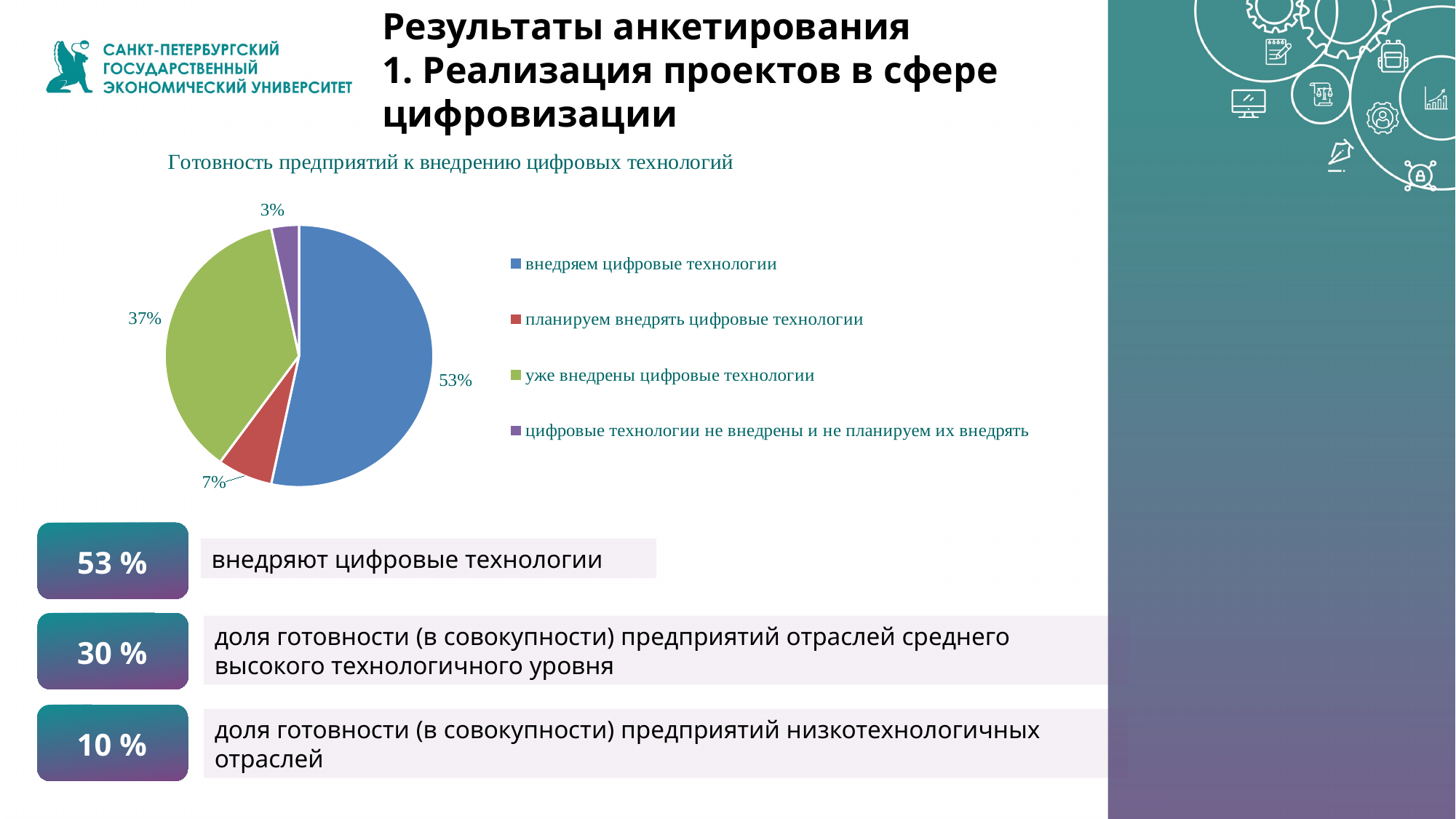
What colour is the slice for "уже внедрены цифровые технологии"? green What type of chart is shown on the slide? pie chart What is the difference in percentage points between "внедряем цифровые технологии" and "уже внедрены цифровые технологии"? 16 Which is larger: the slice for "планируем внедрять цифровые технологии" or the slice for "цифровые технологии не внедрены и не планируем их внедрять"? планируем внедрять цифровые технологии What share of the pie corresponds to "внедряем цифровые технологии"? 53% Which category has the smallest slice of the pie? цифровые технологии не внедрены и не планируем их внедрять What is the title of the chart? Готовность предприятий к внедрению цифровых технологий What share of the pie corresponds to "цифровые технологии не внедрены и не планируем их внедрять"? 3% What share of the pie corresponds to "уже внедрены цифровые технологии"? 37% How many categories does the pie chart show? 4 Which category has the largest slice of the pie? внедряем цифровые технологии What share of the pie corresponds to "планируем внедрять цифровые технологии"? 7%